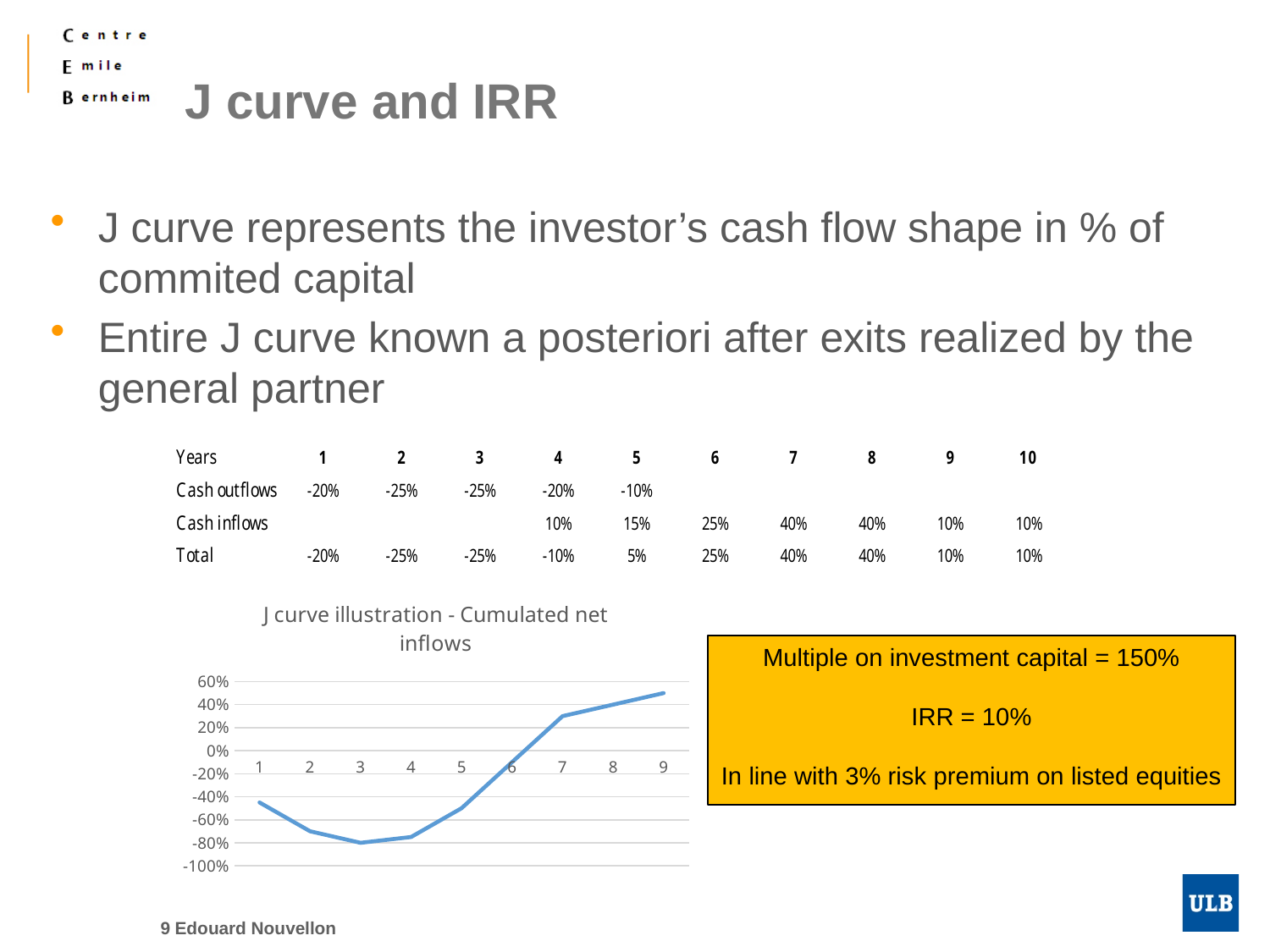
What is the title of the chart? J curve illustration - Cumulated net inflows Is the value at point 9 greater or less than 40%? greater What kind of chart is shown on the slide? line chart Is the value at point 7 greater or less than 20%? greater Which has the larger value, point 2 or point 5? point 5 Does the line rise or fall between point 3 and point 9? rise Is the value at point 6 greater or less than 0%? less At which x-axis point does the line reach its highest value? 9 How many points are plotted along the x axis of the chart? 9 What is the lowest value shown on the chart's y axis? -100%